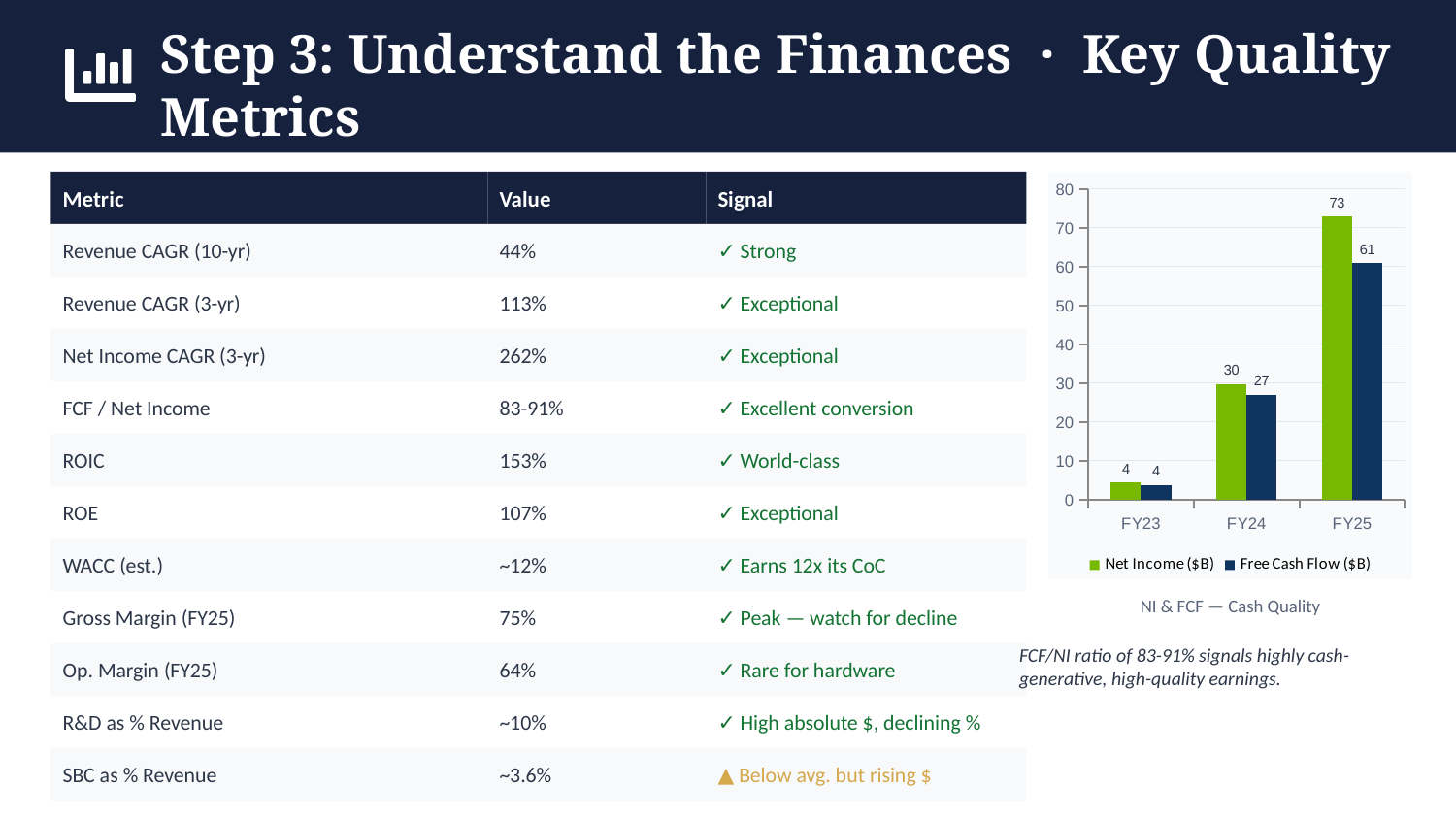
What is the difference between Net Income and Free Cash Flow in FY25? 12 What is the difference in Net Income ($B) between FY25 and FY24? 43 What is the Free Cash Flow ($B) value for FY23? 4 How many series does the chart legend list? 2 How many years are shown on the x axis of the chart? 3 What kind of chart is shown on the slide? Bar chart Which year has the highest Net Income ($B)? FY25 What is the Free Cash Flow ($B) value for FY24? 27 What is the Net Income ($B) value for FY25? 73 Which is larger in FY24: Net Income or Free Cash Flow? Net Income Which year has the lowest Free Cash Flow ($B)? FY23 Does Free Cash Flow rise or fall from FY23 to FY25? Rise